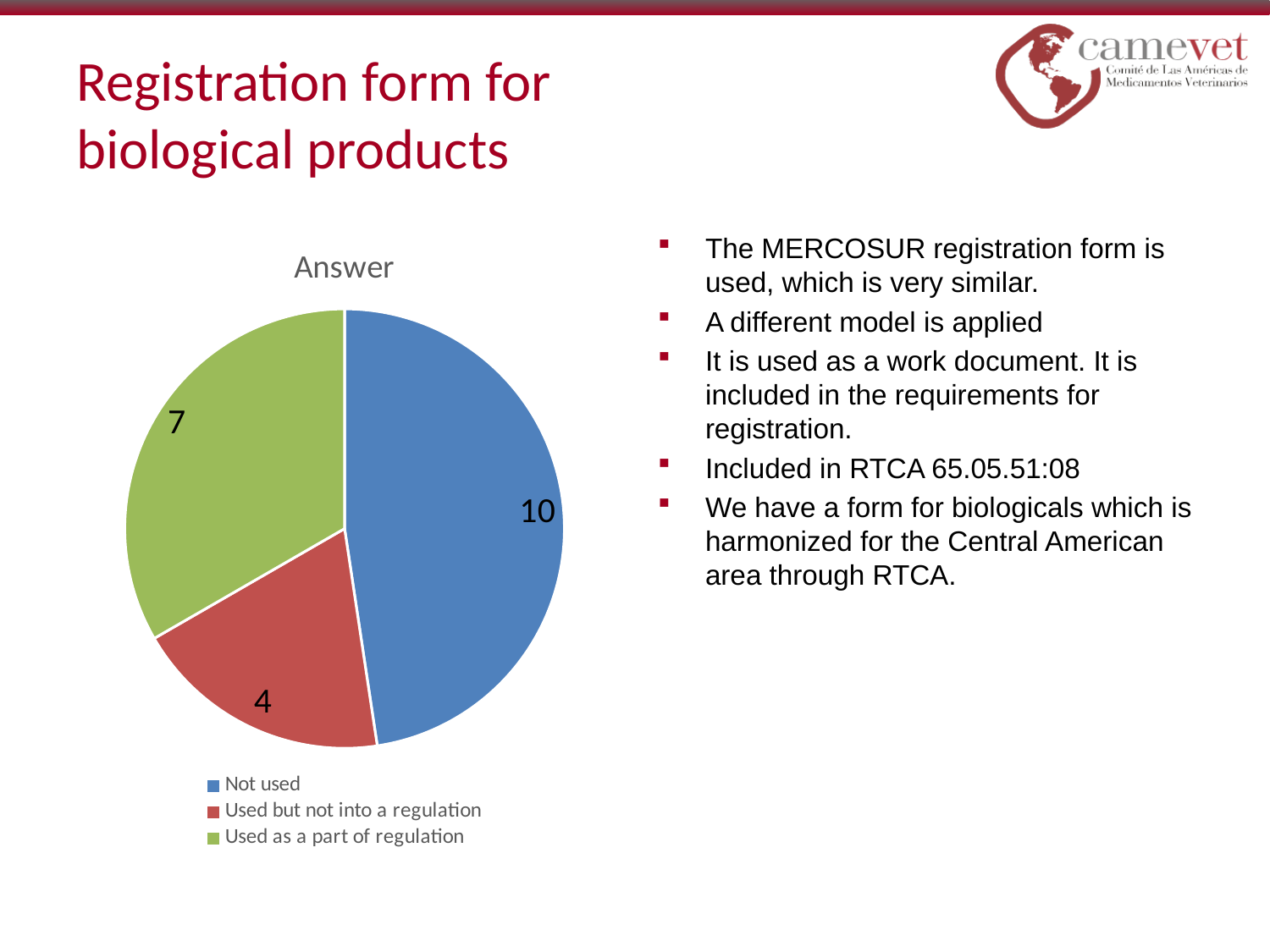
What is the value for "Not used"? 10 Which is larger, the value for "Used as a part of regulation" or "Used but not into a regulation"? Used as a part of regulation Which colour represents "Used as a part of regulation" in the legend? green What is the title of the chart? Answer What is the difference between the values for "Not used" and "Used as a part of regulation"? 3 What is the value for "Used as a part of regulation"? 7 How many slices does the pie chart have? 3 Which category has the smallest slice? Used but not into a regulation What is the total of all slices in the pie chart? 21 What kind of chart is shown on the slide? pie chart What is the value for "Used but not into a regulation"? 4 Which category has the largest slice? Not used